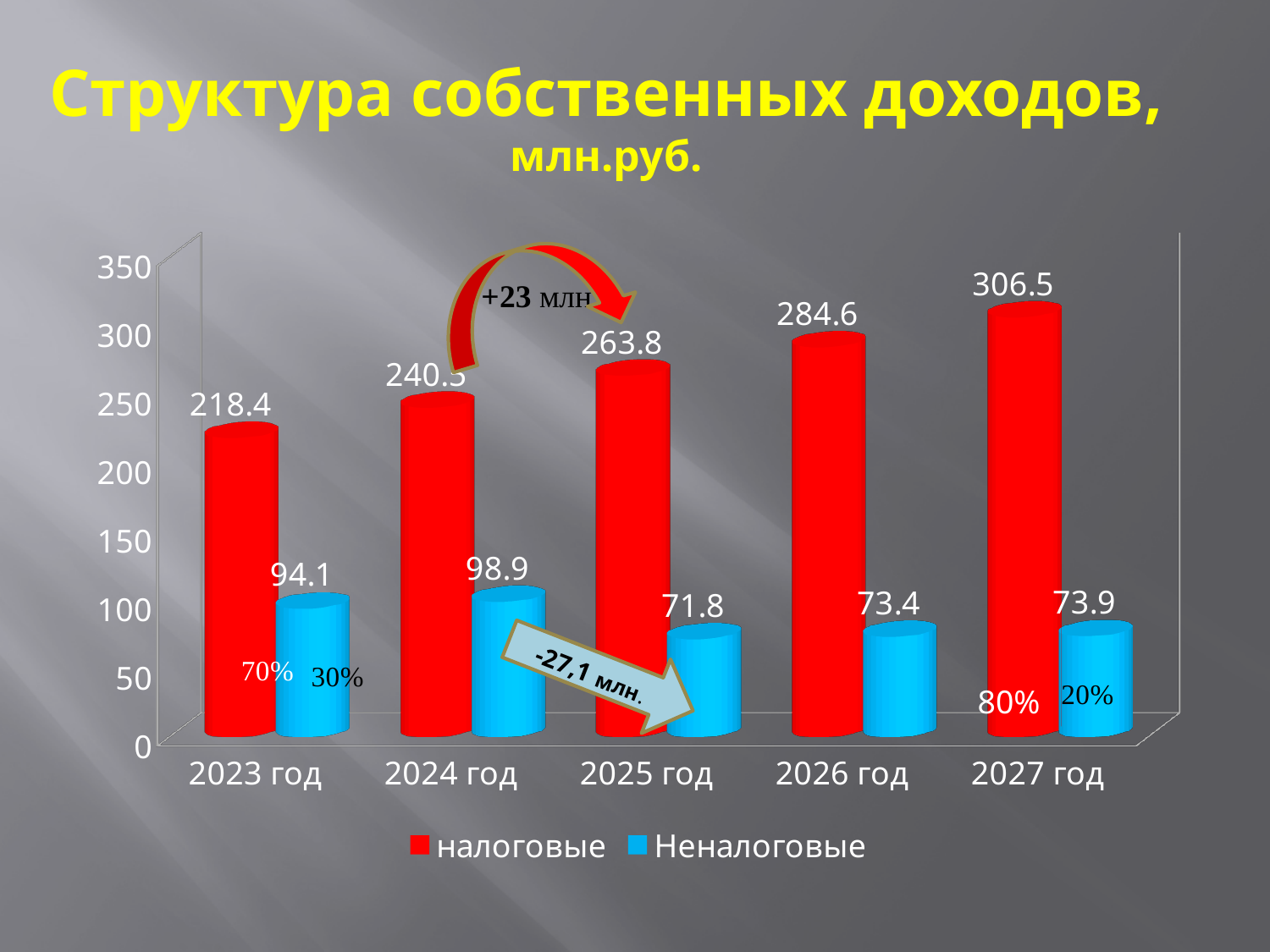
What is the value for Неналоговые in 2025 год? 71.8 Is the налоговые value for 2026 год greater or less than 250? greater What is the difference between the налоговые values for 2027 год and 2026 год? 21.9 In 2023 год, which is larger: налоговые or Неналоговые? налоговые In which year is the налоговые value highest? 2027 год What is the value for налоговые in 2023 год? 218.4 Do the налоговые values rise or fall from 2023 год to 2027 год? rise In which year is the Неналоговые value lowest? 2025 год What is the value for налоговые in 2027 год? 306.5 How many years are shown on the x axis? 5 By how much does the Неналоговые value fall from 2024 год to 2025 год? 27.1 How many series does the legend list? 2